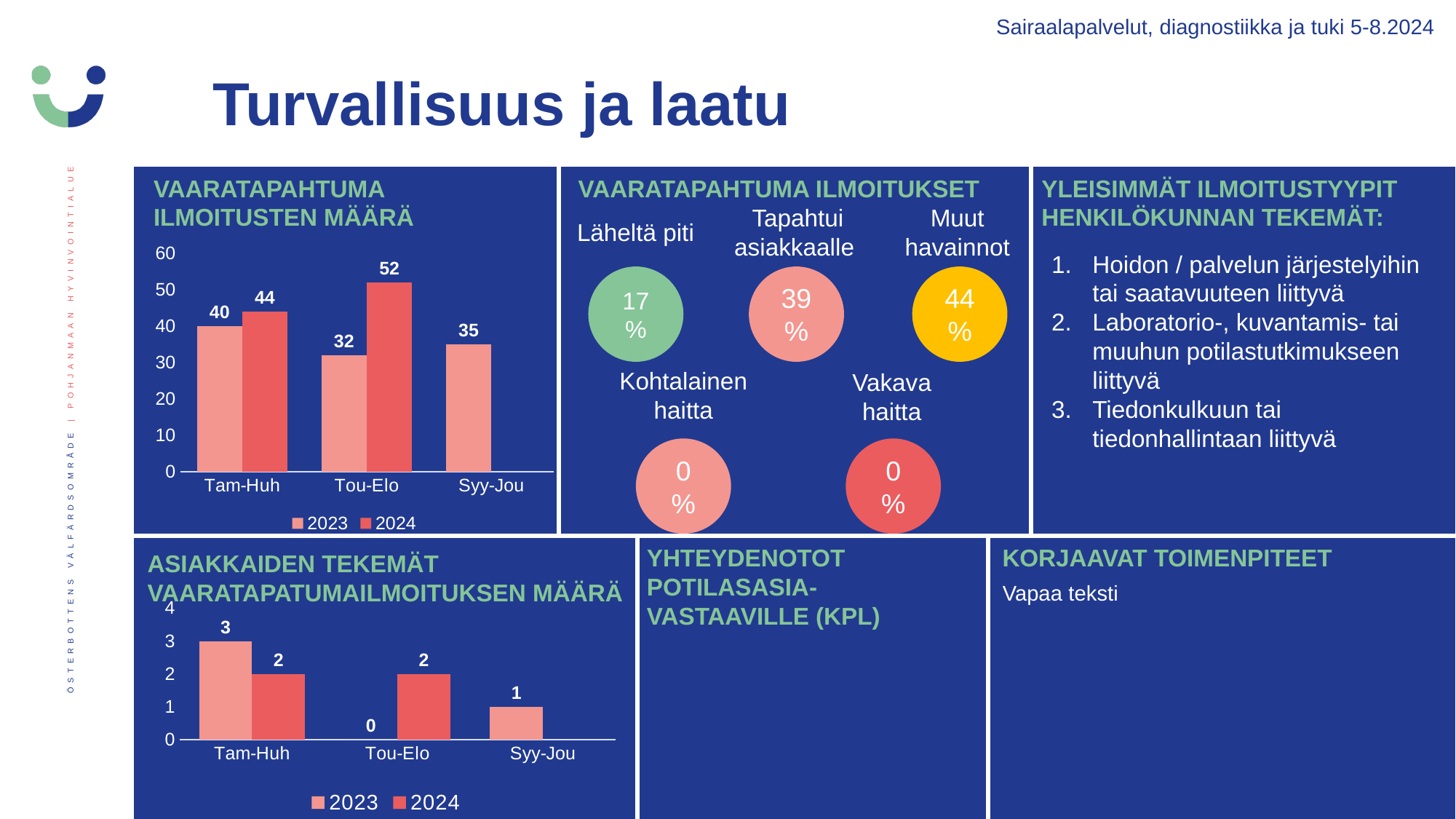
What kind of chart is the VAARATAPAHTUMA ILMOITUSTEN MÄÄRÄ chart? Bar chart In the ASIAKKAIDEN TEKEMÄT VAARATAPATUMAILMOITUKSEN MÄÄRÄ chart, which category has the highest 2023 value? Tam-Huh In the VAARATAPAHTUMA ILMOITUSTEN MÄÄRÄ chart, which category has the lowest 2023 value? Tou-Elo In the VAARATAPAHTUMA ILMOITUSTEN MÄÄRÄ chart, which is larger for Tam-Huh: the 2023 value or the 2024 value? 2024 In the VAARATAPAHTUMA ILMOITUSTEN MÄÄRÄ chart, what is the 2024 value for Tou-Elo? 52 In the VAARATAPAHTUMA ILMOITUSTEN MÄÄRÄ chart, what is the 2023 value for Syy-Jou? 35 In the ASIAKKAIDEN TEKEMÄT VAARATAPATUMAILMOITUKSEN MÄÄRÄ chart, what is the 2023 value for Tou-Elo? 0 In the VAARATAPAHTUMA ILMOITUSTEN MÄÄRÄ chart, how many series does the legend list? 2 In the VAARATAPAHTUMA ILMOITUSTEN MÄÄRÄ chart, what is the difference between the 2024 and 2023 values for Tou-Elo? 20 In the ASIAKKAIDEN TEKEMÄT VAARATAPATUMAILMOITUKSEN MÄÄRÄ chart, do the 2023 values rise or fall from Tam-Huh to Tou-Elo? Fall In the ASIAKKAIDEN TEKEMÄT VAARATAPATUMAILMOITUKSEN MÄÄRÄ chart, what is the 2023 value for Tam-Huh? 3 In the ASIAKKAIDEN TEKEMÄT VAARATAPATUMAILMOITUKSEN MÄÄRÄ chart, how many categories are shown on the x axis? 3